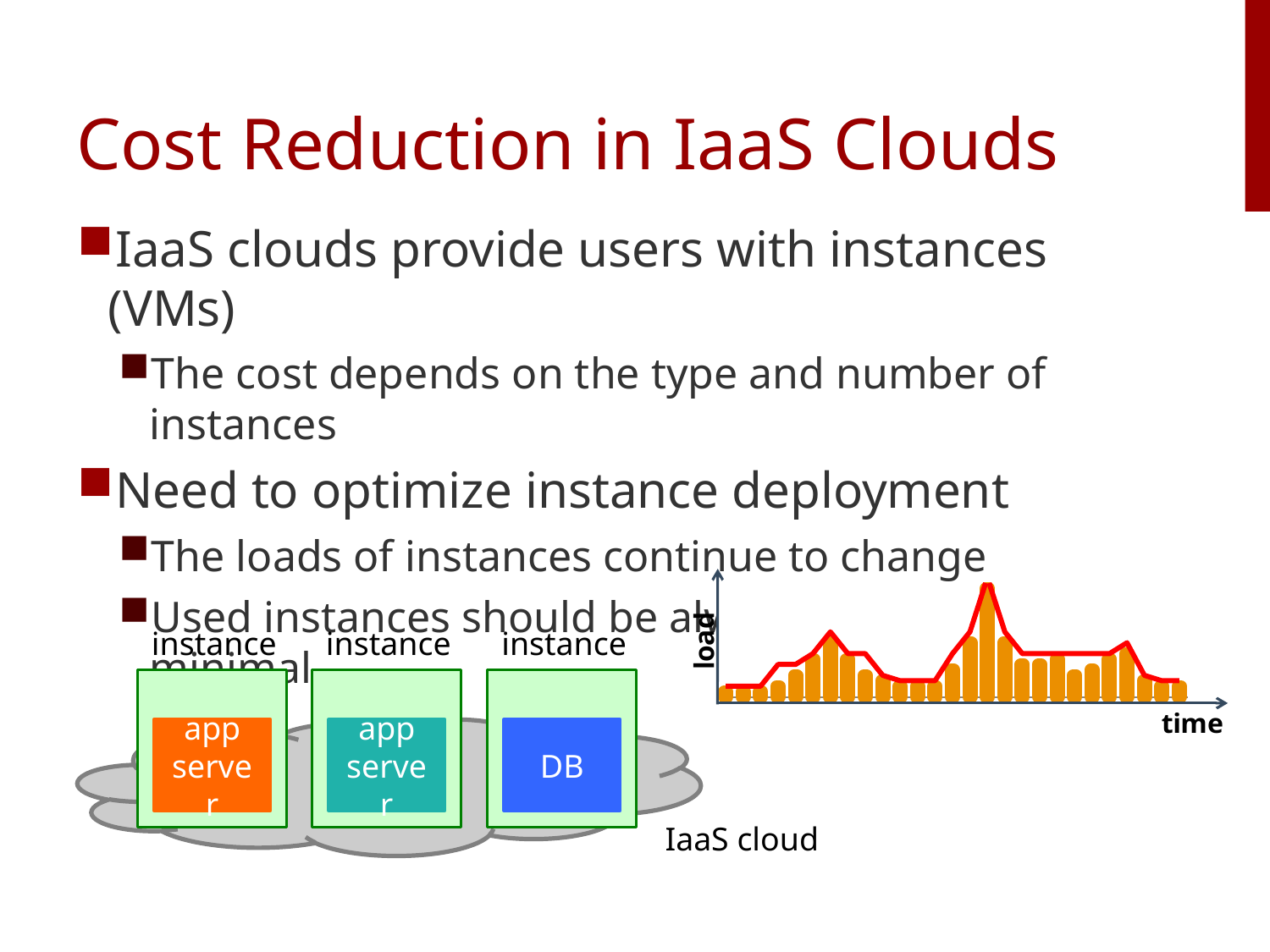
Does the load in the chart stay constant over time, or does it fluctuate? it fluctuates What is the label on the horizontal axis of the chart? time What is the label on the vertical axis of the chart? load What kind of chart is shown in the lower right of the slide? bar chart with a red line overlay